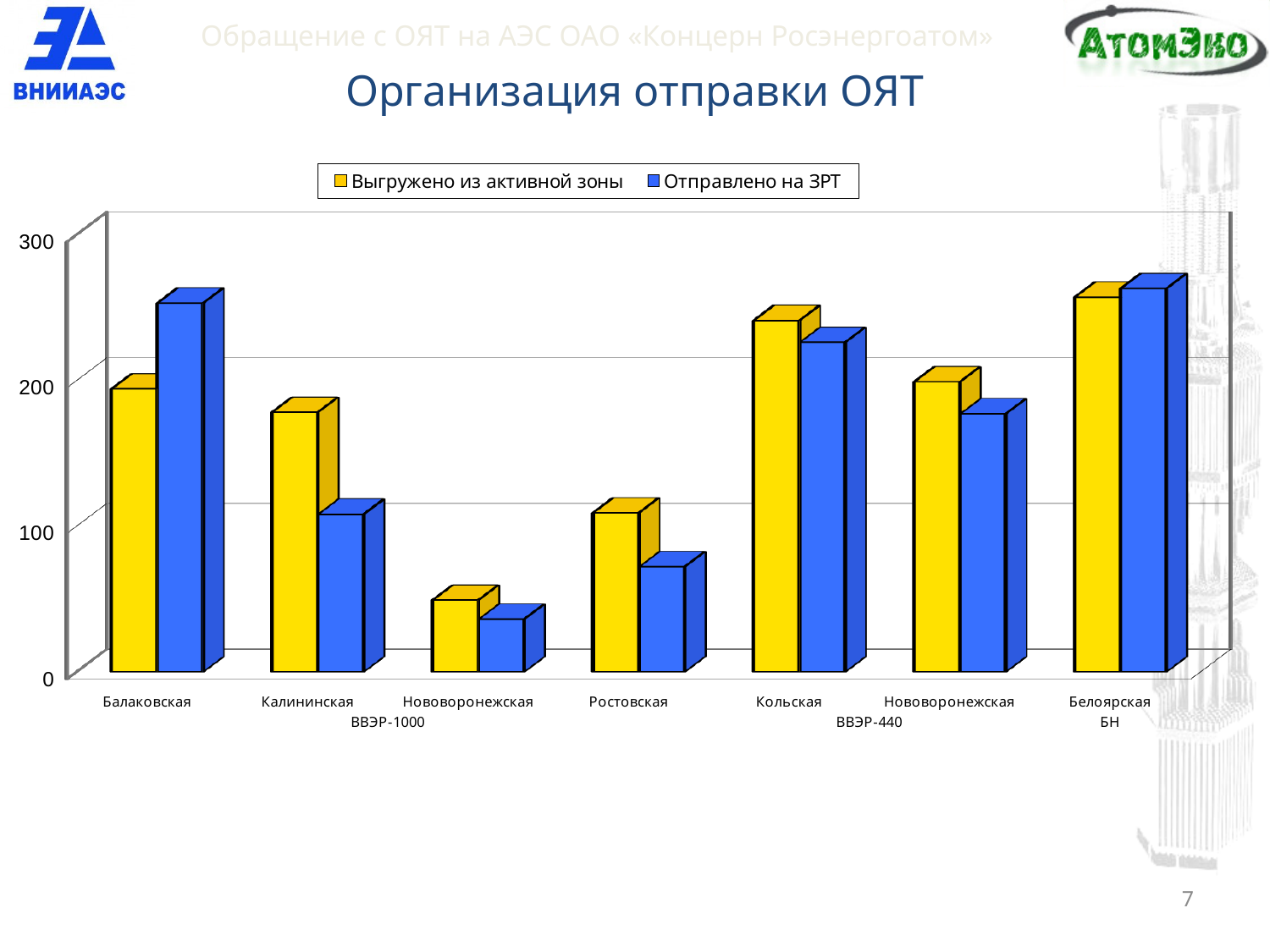
Which colour represents the series "Отправлено на ЗРТ"? blue How many series does the legend list? 2 What is the title of the chart? Организация отправки ОЯТ For Балаковская, which is larger: "Выгружено из активной зоны" or "Отправлено на ЗРТ"? Отправлено на ЗРТ How many power plant categories are shown along the x axis? 7 For Калининская, which is larger: "Выгружено из активной зоны" or "Отправлено на ЗРТ"? Выгружено из активной зоны Is the value of "Отправлено на ЗРТ" for Балаковская greater or less than 200? greater Is the value of "Отправлено на ЗРТ" for Ростовская greater or less than 100? less Which category has the lowest value of "Выгружено из активной зоны"? Нововоронежская (ВВЭР-1000) What kind of chart is shown on the slide? bar chart Is the value of "Выгружено из активной зоны" for Кольская greater or less than 200? greater